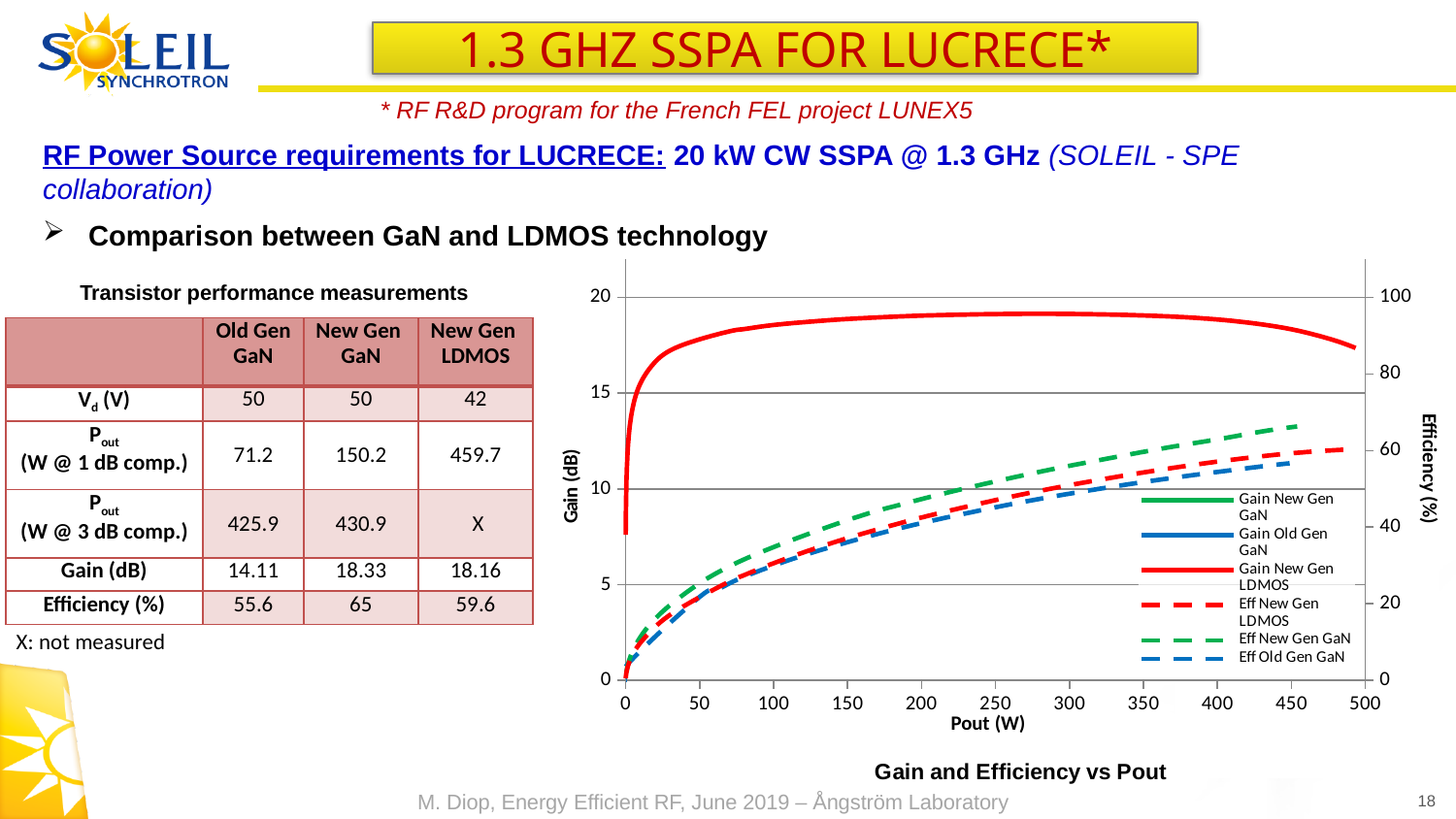
Is the Gain New Gen LDMOS value at Pout = 250 W greater or less than 15 dB? greater What is the label of the x axis of the 'Gain and Efficiency vs Pout' chart? Pout (W) Is the Eff New Gen GaN value at Pout = 450 W greater or less than 60%? greater What kind of chart is shown on the slide? line chart What is the label of the right-hand y axis of the 'Gain and Efficiency vs Pout' chart? Efficiency (%) Does the Eff New Gen GaN curve rise or fall as Pout increases? rise Is the Eff Old Gen GaN value at Pout = 400 W greater or less than 60%? less Does the Gain New Gen LDMOS curve rise or fall between Pout = 400 W and Pout = 500 W? fall Which series has the highest gain across the plotted Pout range in the 'Gain and Efficiency vs Pout' chart? Gain New Gen LDMOS At Pout = 400 W, which is higher: Eff New Gen GaN or Eff Old Gen GaN? Eff New Gen GaN How many series does the legend of the 'Gain and Efficiency vs Pout' chart list? 6